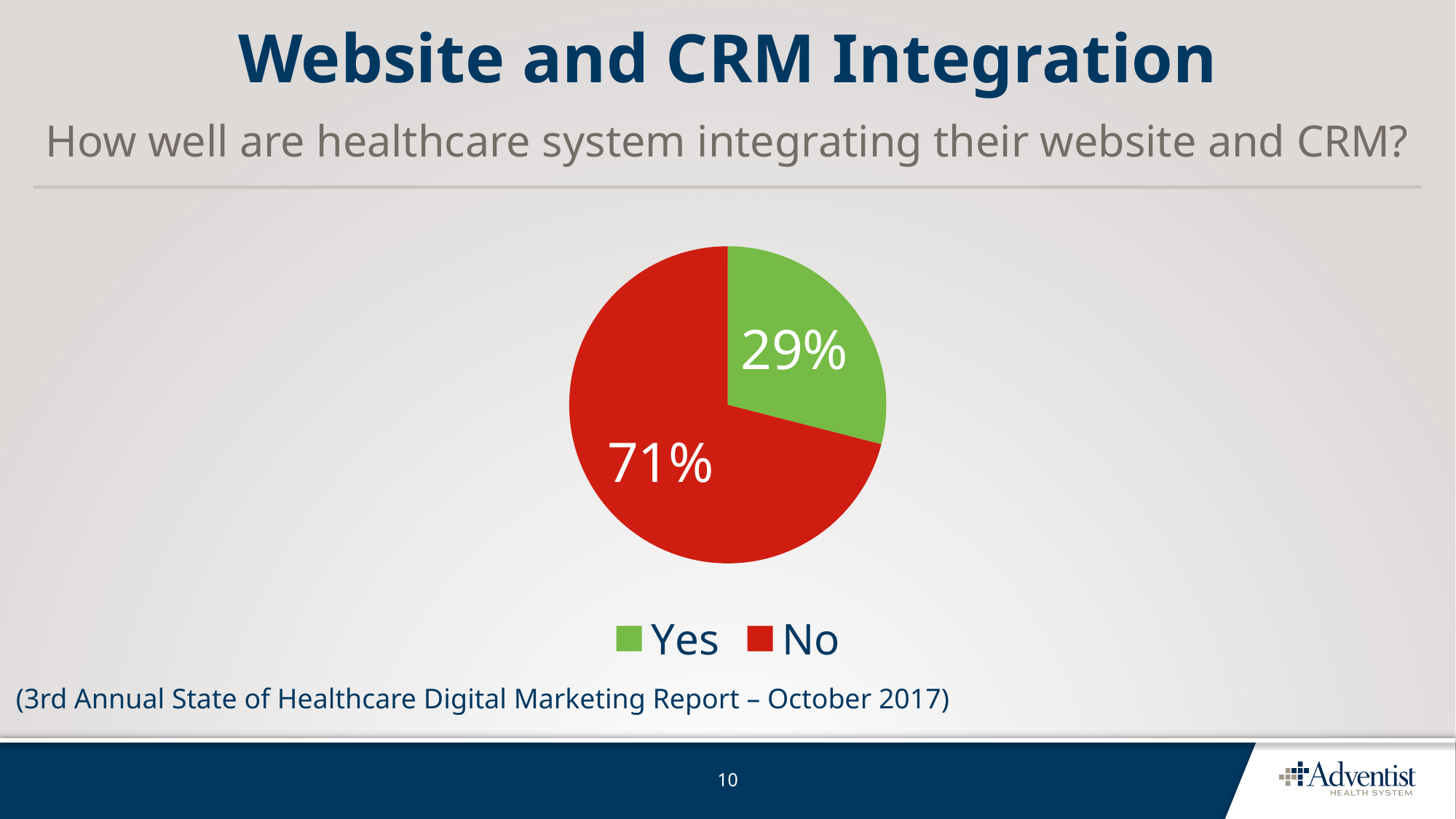
What share of the pie does the "No" slice represent? 71% How many slices does the pie chart have? 2 Which slice of the pie is the smallest? Yes What percentage of the pie is labelled "Yes"? 29% What kind of chart is shown on the slide? pie chart Which is larger, the "Yes" slice or the "No" slice? No What colour is the "No" slice in the pie chart? red What colour is the "Yes" slice in the pie chart? green What is the difference in percentage points between the "No" slice and the "Yes" slice? 42 What percentage of the pie is labelled "No"? 71% How many entries does the legend list? 2 Which slice of the pie is the largest? No